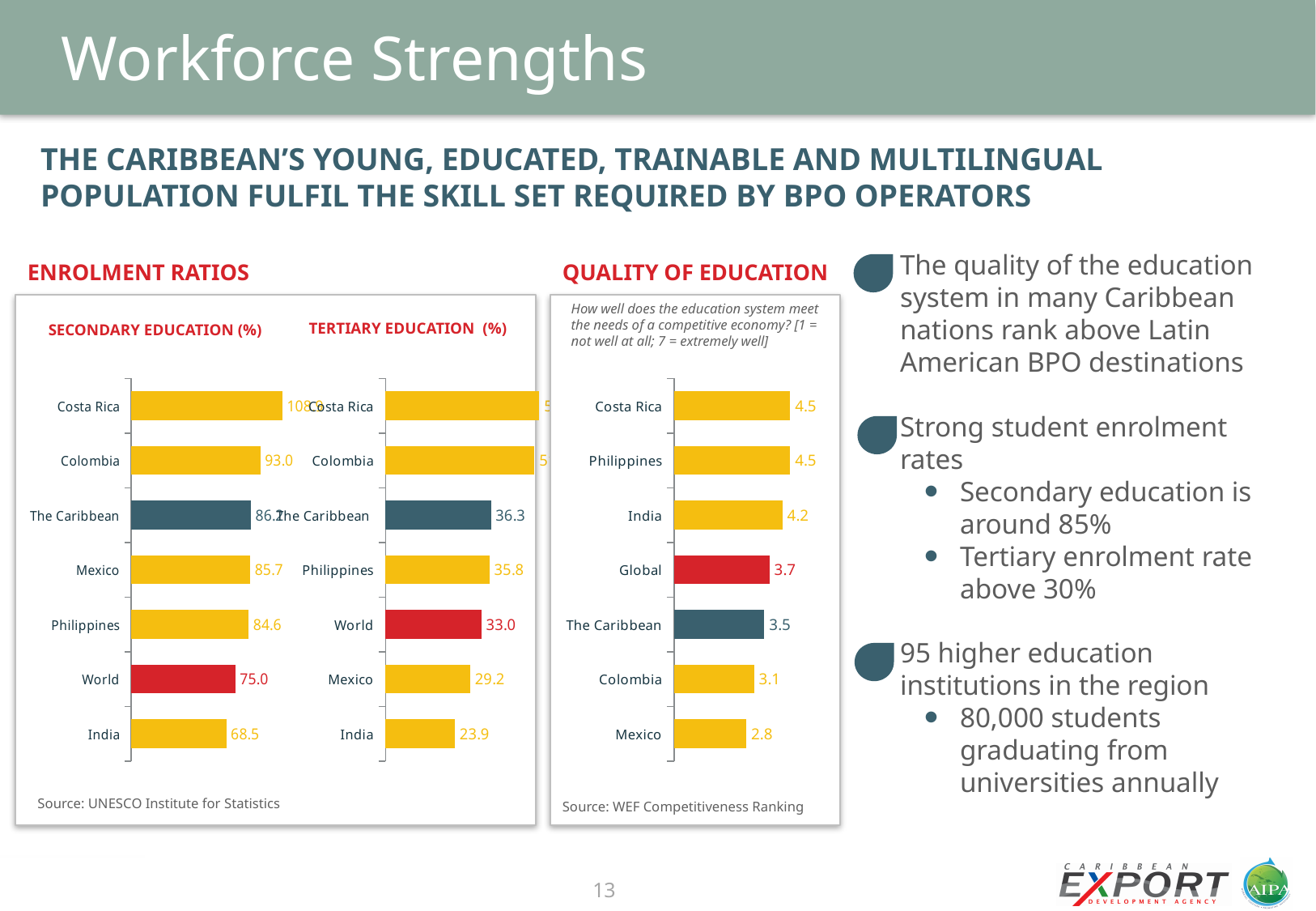
In the Quality of Education chart, what is the value for The Caribbean? 3.5 In the Secondary Education (%) chart, which category has the lowest value? India In the Secondary Education (%) chart, what is the difference between Colombia and World? 18.0 In the Secondary Education (%) chart, what is the value for India? 68.5 In the Quality of Education chart, what is the difference between India and Colombia? 1.1 In the Tertiary Education (%) chart, which is larger, Mexico or India? Mexico In the Tertiary Education (%) chart, what is the value for World? 33.0 What type of chart is the Quality of Education chart? Bar chart In the Secondary Education (%) chart, what is the value for Mexico? 85.7 In the Tertiary Education (%) chart, how many categories are shown? 7 In the Quality of Education chart, which category has the lowest value? Mexico In the Tertiary Education (%) chart, what is the value for The Caribbean? 36.3